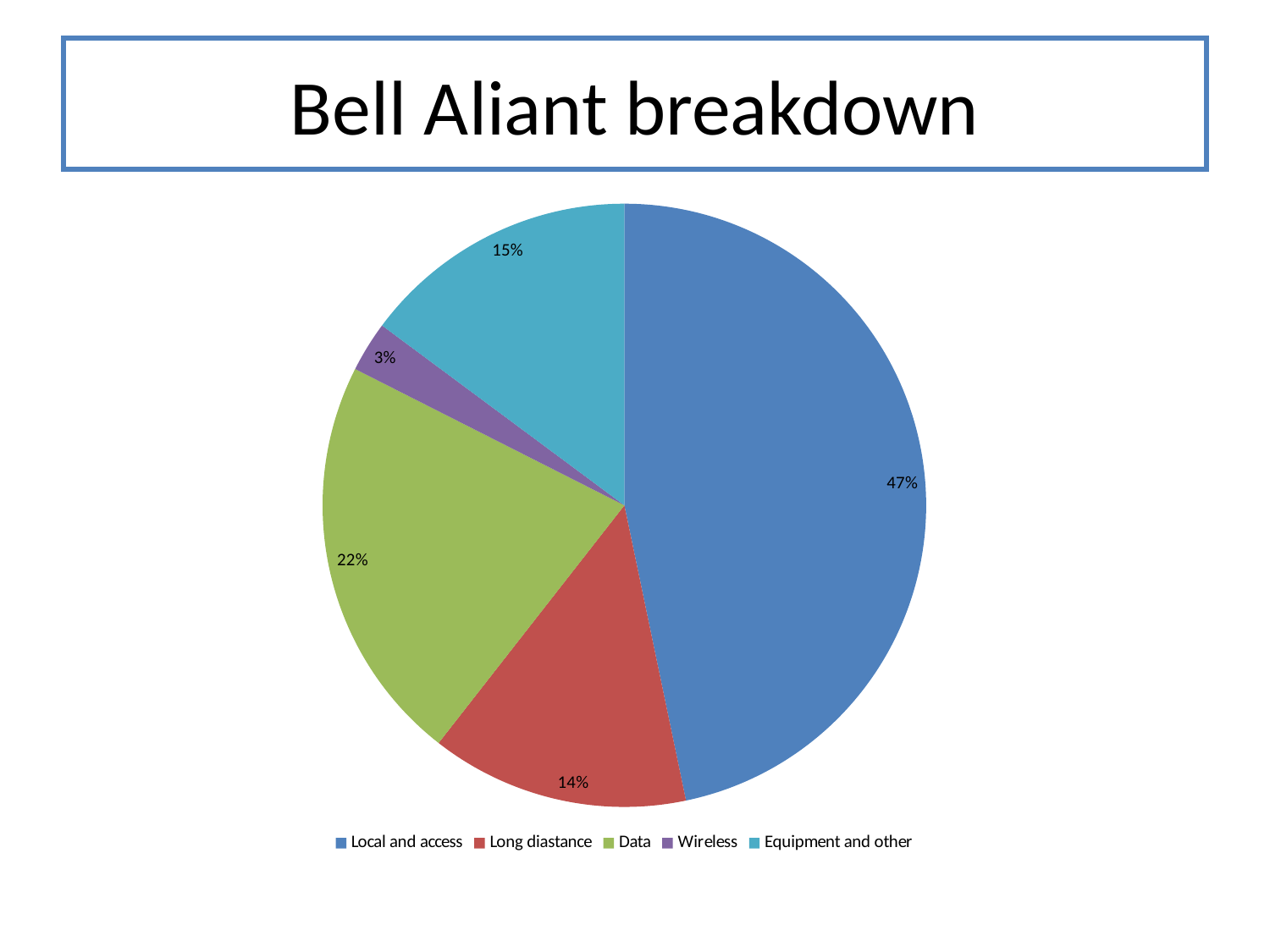
Which is larger, the Data slice or the Equipment and other slice? Data What is the title of the slide containing the pie chart? Bell Aliant breakdown How many slices does the pie chart have? 5 Which category has the smallest slice of the pie? Wireless What kind of chart is shown on the slide? pie chart What is the difference in percentage points between Local and access and Data? 25% What share of the pie does Wireless have? 3% What share of the pie does Equipment and other have? 15% What share of the pie does Long diastance have? 14% Which category has the largest slice of the pie? Local and access